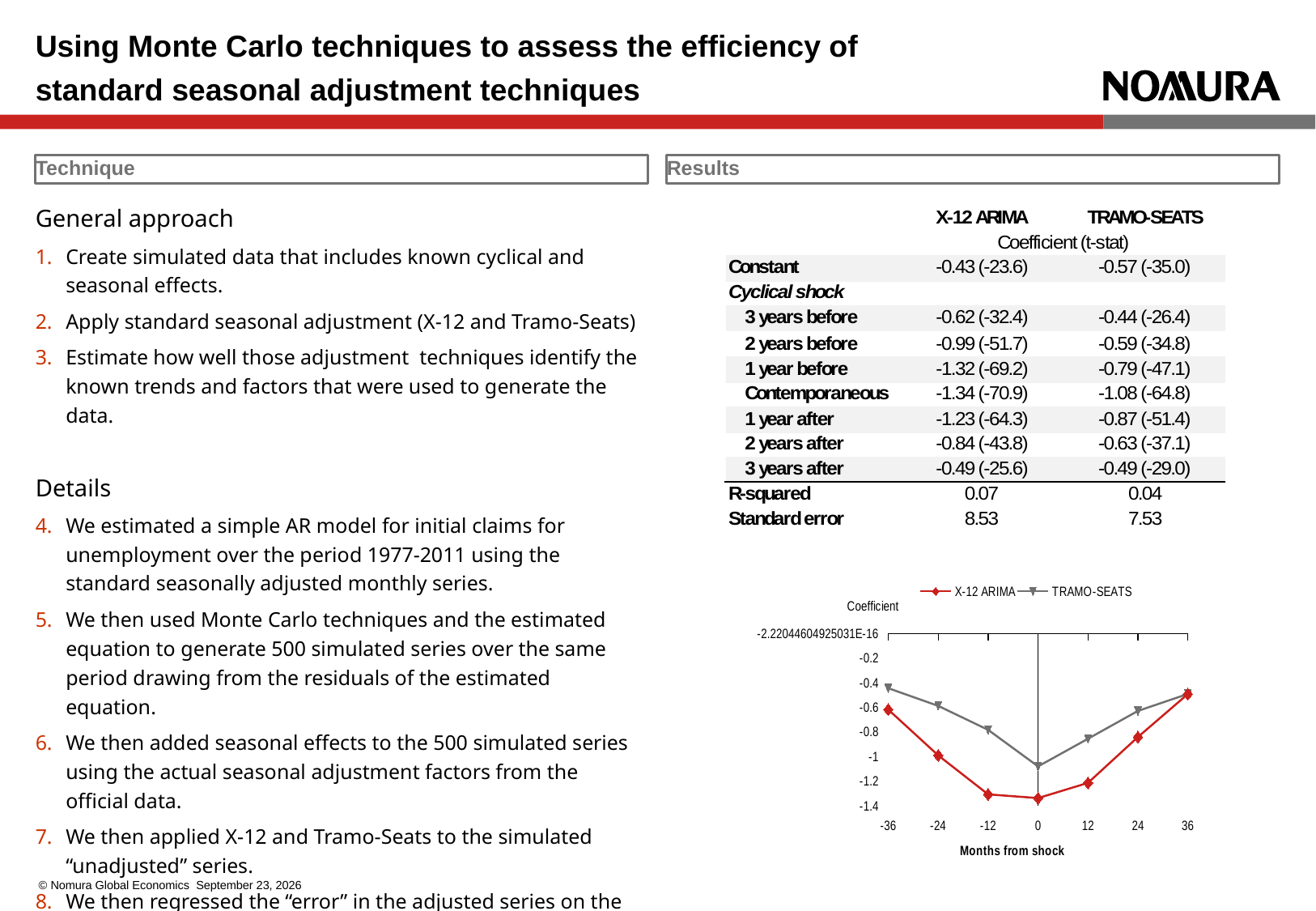
What kind of chart is shown at the bottom right of the slide? line chart How many points are plotted for the X-12 ARIMA series in the chart? 7 In the chart, is the TRAMO-SEATS value at 0 months from shock greater or less than -1.2? greater Which series in the chart is drawn in red? X-12 ARIMA At which value of months from shock does the TRAMO-SEATS series reach its lowest point in the chart? 0 In the chart, which series has the higher value at -12 months from shock, X-12 ARIMA or TRAMO-SEATS? TRAMO-SEATS In the chart, is the X-12 ARIMA value at 0 months from shock greater or less than -1.2? less In the chart, does the X-12 ARIMA series rise or fall as months from shock goes from -36 to 0? fall What is the title of the x axis of the chart? Months from shock In the chart, is the X-12 ARIMA value at -24 months from shock greater or less than -0.8? less How many series does the legend of the chart list? 2